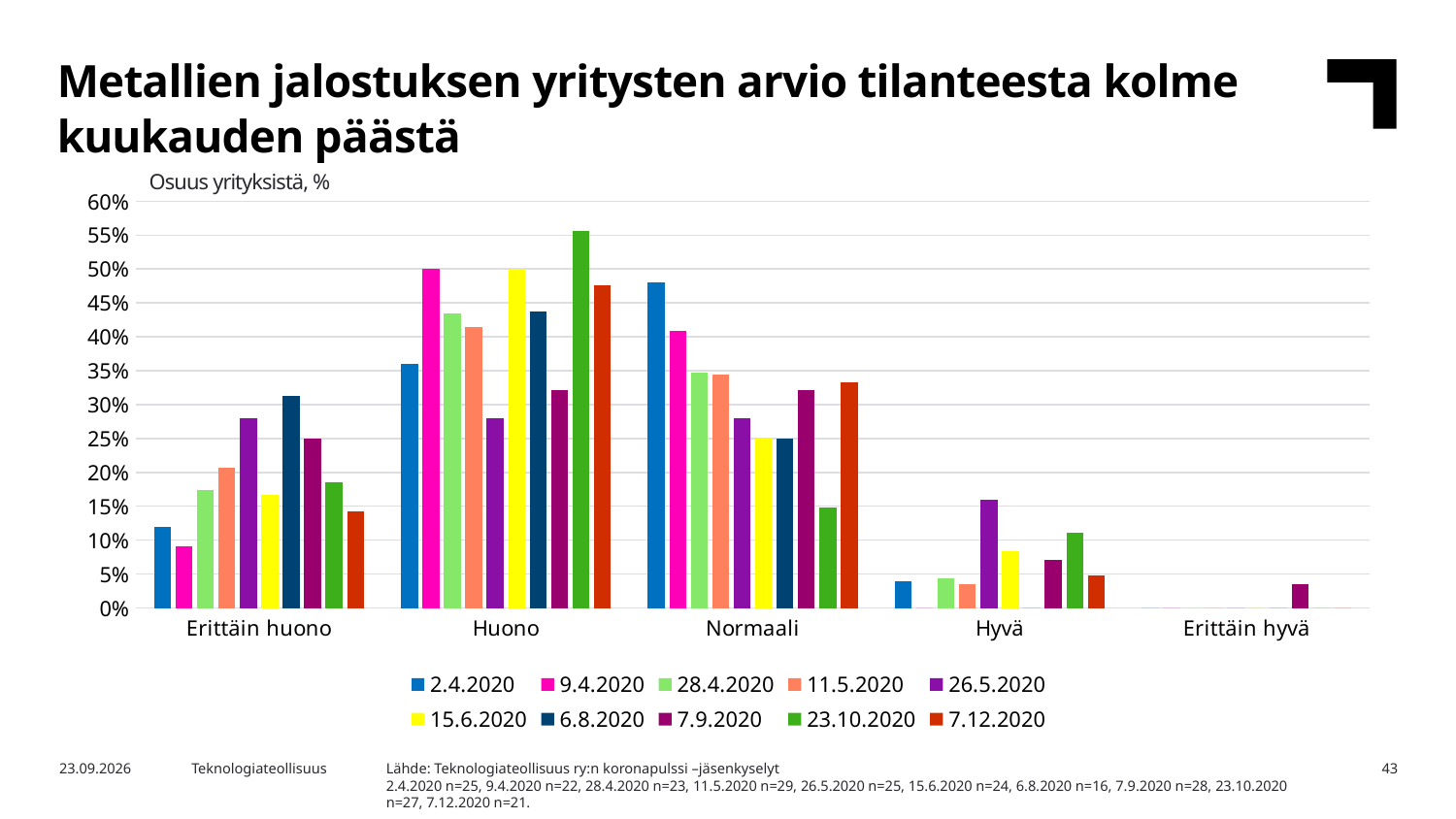
In the Erittäin huono category, which series has the highest bar? 6.8.2020 How many series does the legend list? 10 Is the value for 23.10.2020 in the Huono category greater or less than 50%? greater How many categories are shown on the x axis? 5 In the Huono category, which series has the highest bar? 23.10.2020 What kind of chart is shown on the slide? Bar chart What is the label shown above the vertical axis of the chart? Osuus yrityksistä, % In the Erittäin huono category, which is larger: the value for 6.8.2020 or for 2.4.2020? 6.8.2020 Is the value for 2.4.2020 in the Normaali category greater or less than 45%? greater Is the value for 26.5.2020 in the Hyvä category greater or less than 10%? greater In the Normaali category, which series has the lowest bar? 23.10.2020 In the Hyvä category, which is larger: the value for 23.10.2020 or for 7.12.2020? 23.10.2020